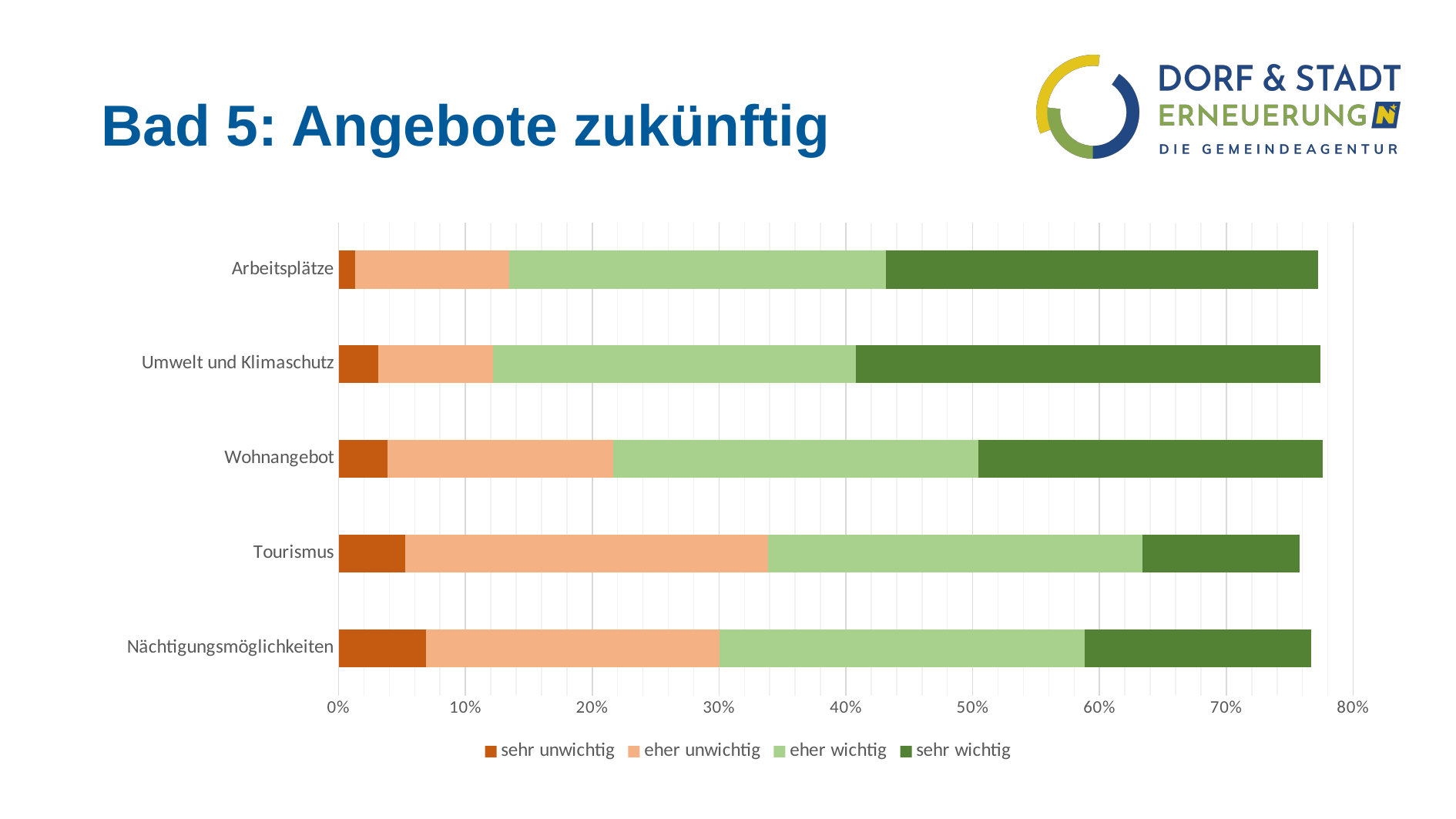
Which category has the largest 'sehr unwichtig' segment? Nächtigungsmöglichkeiten Which category has the smallest 'sehr wichtig' segment? Tourismus Is the 'sehr wichtig' value for Arbeitsplätze greater or less than 30%? greater How many categories are plotted on the y axis of the chart? 5 How many series does the chart legend list? 4 What is the title of the slide containing the chart? Bad 5: Angebote zukünftig Is the 'sehr unwichtig' segment larger for Nächtigungsmöglichkeiten or for Arbeitsplätze? Nächtigungsmöglichkeiten What kind of chart is shown on the slide? Stacked bar chart Which legend entry is shown in dark green? sehr wichtig Is the 'sehr unwichtig' value for Nächtigungsmöglichkeiten greater or less than 10%? less Which category has the largest 'eher unwichtig' segment? Tourismus Which category has the smallest 'sehr unwichtig' segment? Arbeitsplätze